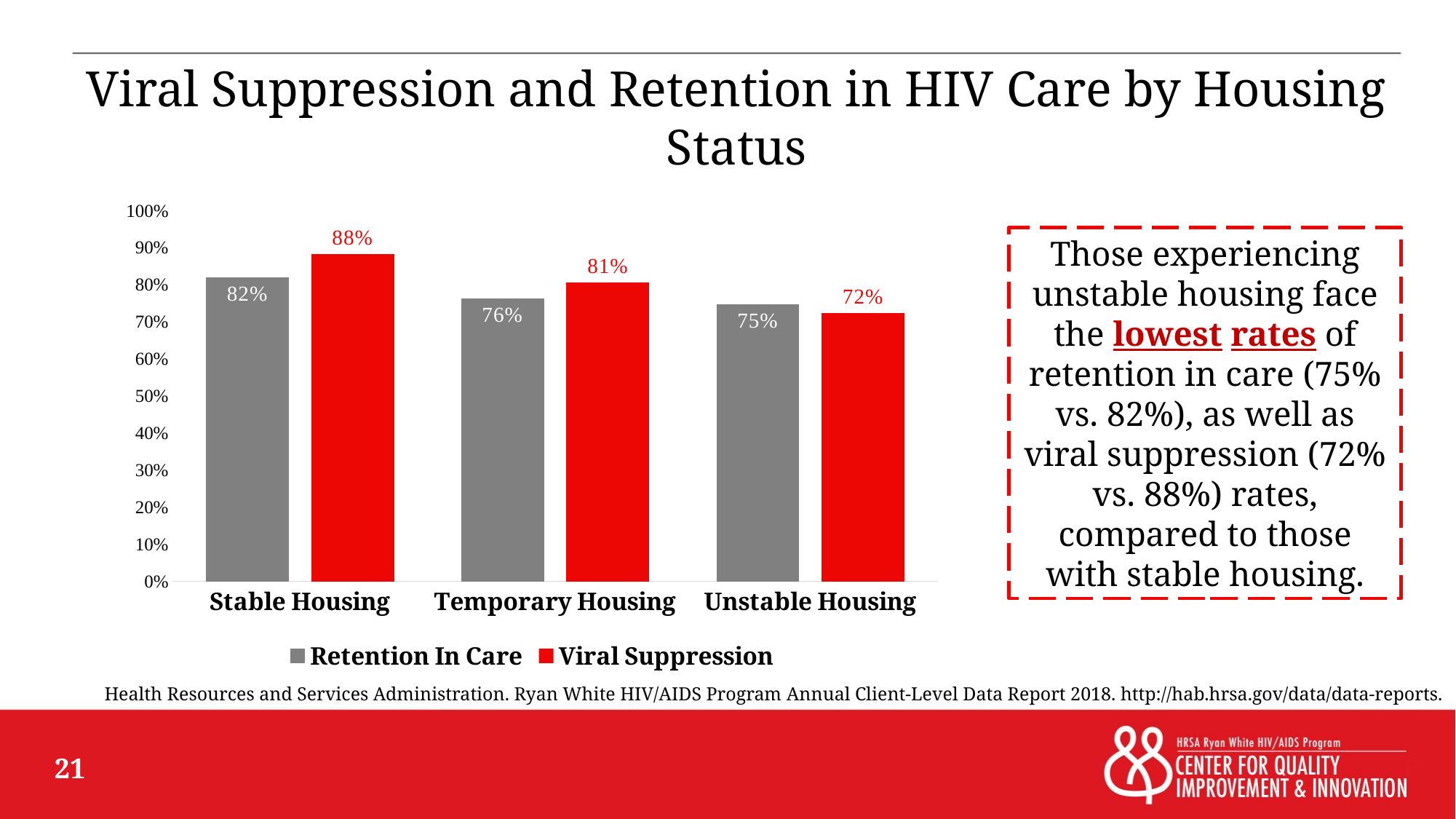
Does the Viral Suppression rate rise or fall from Stable Housing to Unstable Housing? Fall For Unstable Housing, which is larger: Retention In Care or Viral Suppression? Retention In Care How many housing status categories are shown on the x axis? 3 What is the Viral Suppression value for Stable Housing? 88% What is the Retention In Care value for Unstable Housing? 75% What is the Retention In Care value for Temporary Housing? 76% What is the difference between the Viral Suppression rates for Stable Housing and Unstable Housing? 16% Which housing status has the lowest Retention In Care rate? Unstable Housing What kind of chart is shown on the slide? Bar chart What is the Viral Suppression value for Unstable Housing? 72% Which housing status has the highest Viral Suppression rate? Stable Housing How many series does the legend list? 2